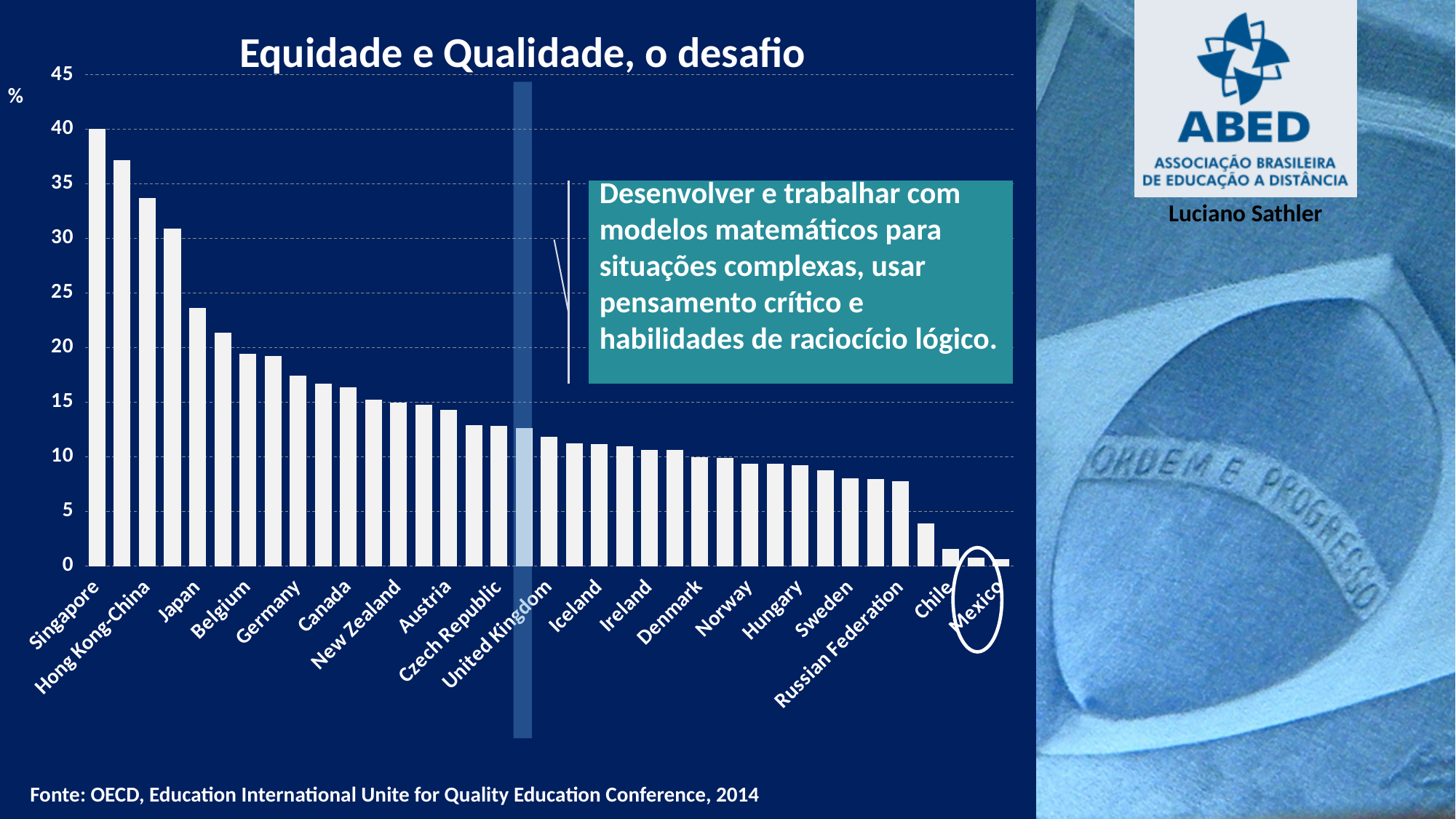
Which country has the highest value in the chart? Singapore Is the value for Singapore greater or less than 35? greater Which country has the lowest value in the chart? Mexico What is the title of the chart? Equidade e Qualidade, o desafio What unit is shown on the y axis of the chart? % What kind of chart is shown on the slide? bar chart Is the value for Japan greater or less than 25? less Is the value for Mexico greater or less than 5? less Do the bar values rise or fall from left to right along the x axis? fall Which has a larger value, Singapore or Hong Kong-China? Singapore